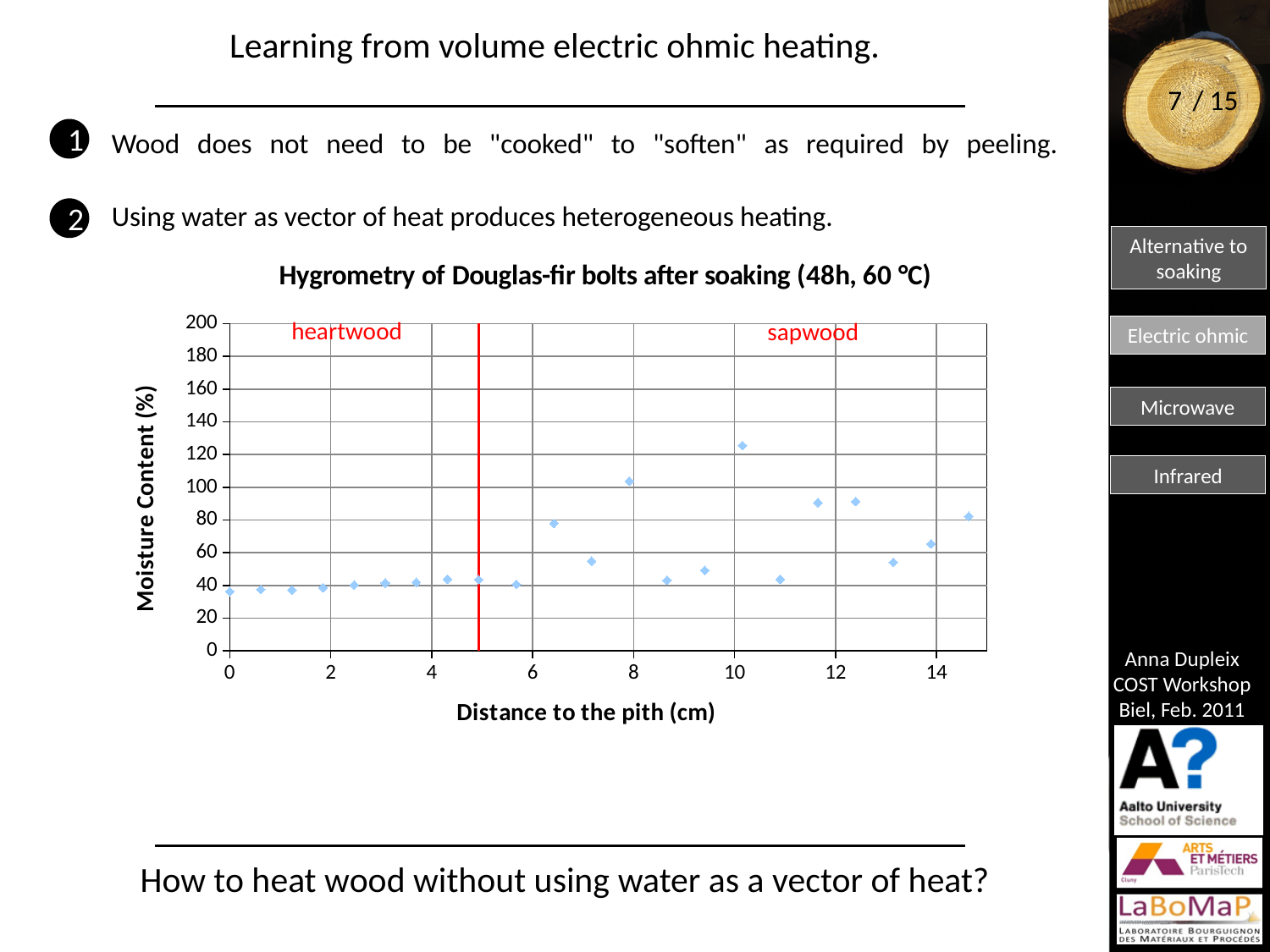
What is the maximum value shown on the y axis of the chart? 200 What kind of chart is shown on the slide? scatter plot Is the highest moisture content value on the chart greater or less than 100? greater Is the moisture content of the point at about 8 cm from the pith greater or less than 80? greater Which region has the lower moisture content values overall, heartwood or sapwood? heartwood Is the moisture content at a distance of 0 cm from the pith greater or less than 40? less In which region, heartwood or sapwood, does the highest moisture content value occur? sapwood How many data points are plotted on the chart? 22 Do the moisture content values generally rise or fall as the distance to the pith increases? rise What is the label of the y axis of the chart? Moisture Content (%) What is the title of the chart? Hygrometry of Douglas-fir bolts after soaking (48h, 60 °C)